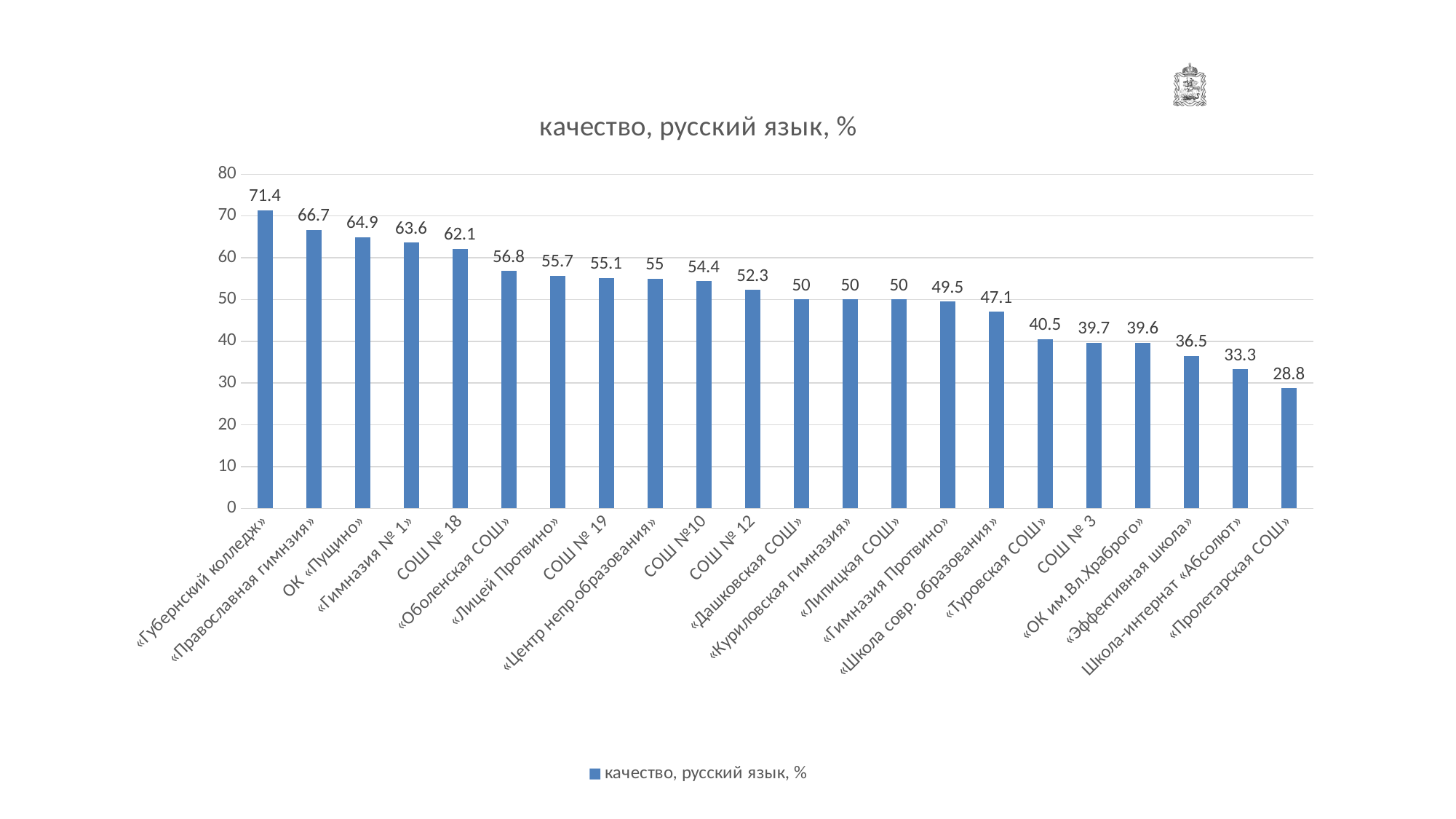
What is the value for «Оболенская СОШ»? 56.8 Which category has the lowest value? «Пролетарская СОШ» What is the value for Школа-интернат «Абсолют»? 33.3 Which category has the highest value? «Губернский колледж» What kind of chart is shown? bar chart How many categories are shown on the x axis? 22 What is the title of the chart? качество, русский язык, % How many series does the legend list? 1 Which is larger, the value for СОШ № 18 or the value for «Лицей Протвино»? СОШ № 18 What is the value for «Туровская СОШ»? 40.5 What is the value for «Губернский колледж»? 71.4 What is the difference between the values for «Губернский колледж» and «Пролетарская СОШ»? 42.6